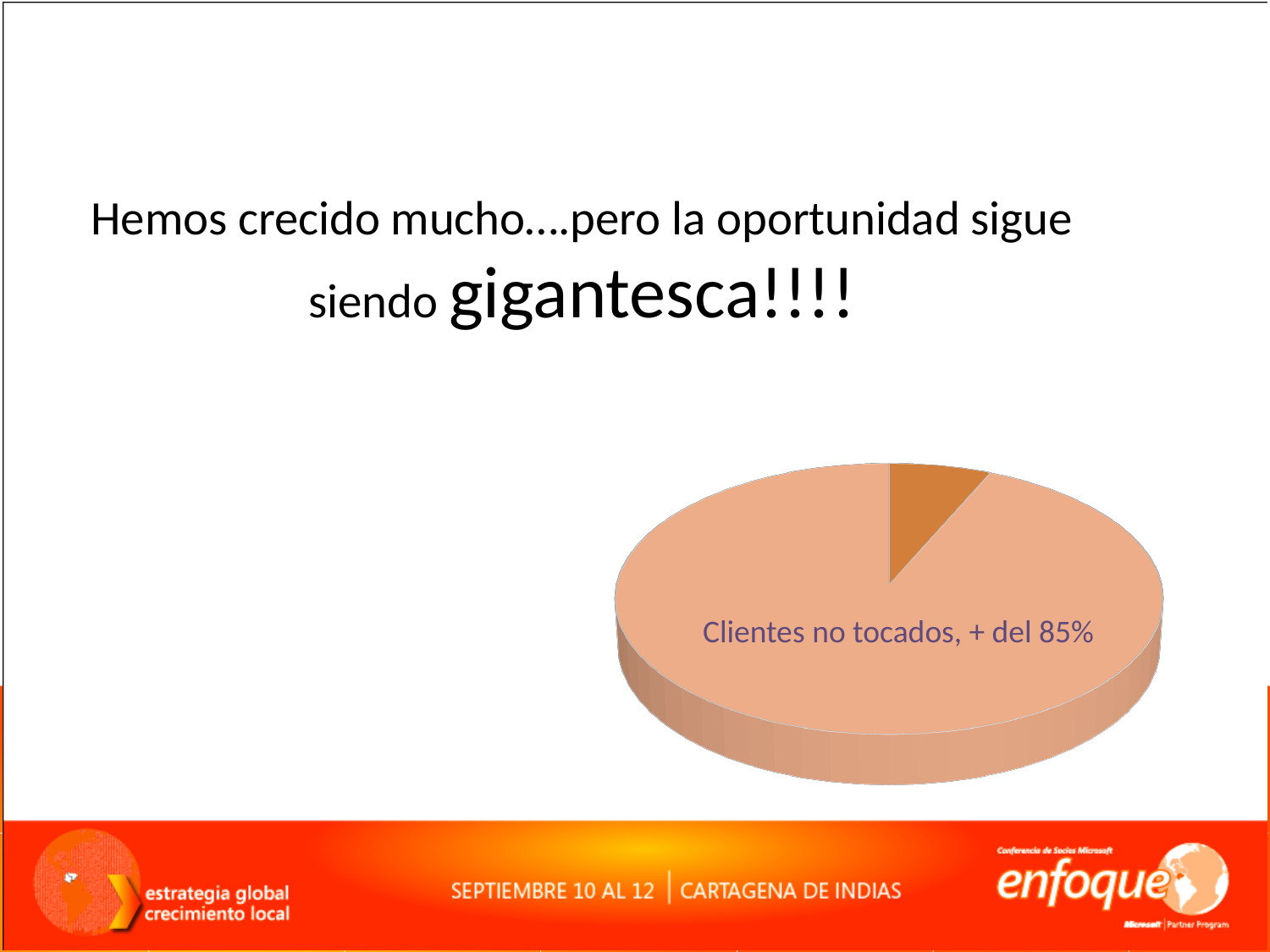
According to the label on the pie chart, what share of the pie do 'Clientes no tocados' represent? + del 85% Is the 'Clientes no tocados' slice greater or less than half of the pie? greater What kind of chart is shown on the slide? Pie chart Which is larger in the pie chart: the slice labeled 'Clientes no tocados' or the small unlabeled slice? Clientes no tocados How many slices does the pie chart have? 2 Which slice of the pie chart is the largest? Clientes no tocados What label is printed on the large slice of the pie chart? Clientes no tocados, + del 85% What colour is the large 'Clientes no tocados' slice of the pie chart? Light orange (peach) Does the pie chart display a legend? No